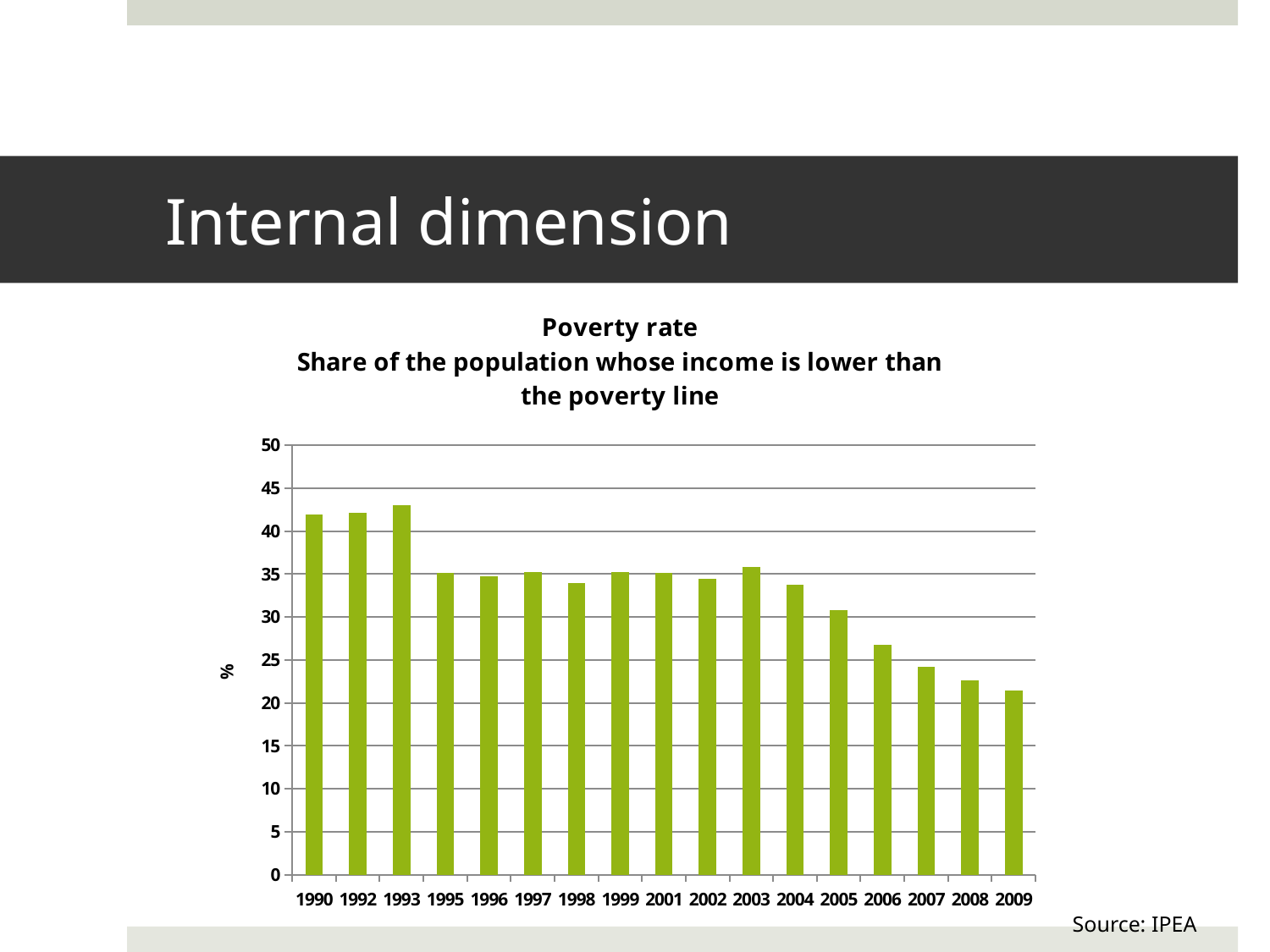
Which year has the lowest poverty rate in the chart? 2009 What is the label on the vertical axis of the chart? % What kind of chart is shown on the slide? bar chart Which year has a higher poverty rate, 2005 or 2006? 2005 Overall, does the poverty rate rise or fall from 1990 to 2009? fall Is the poverty rate for 1990 greater or less than 40? greater Which year has the highest poverty rate in the chart? 1993 Is the poverty rate for 2009 greater or less than 20? greater How many years are plotted on the x axis of the poverty rate chart? 17 Is the poverty rate for 2006 greater or less than 30? less